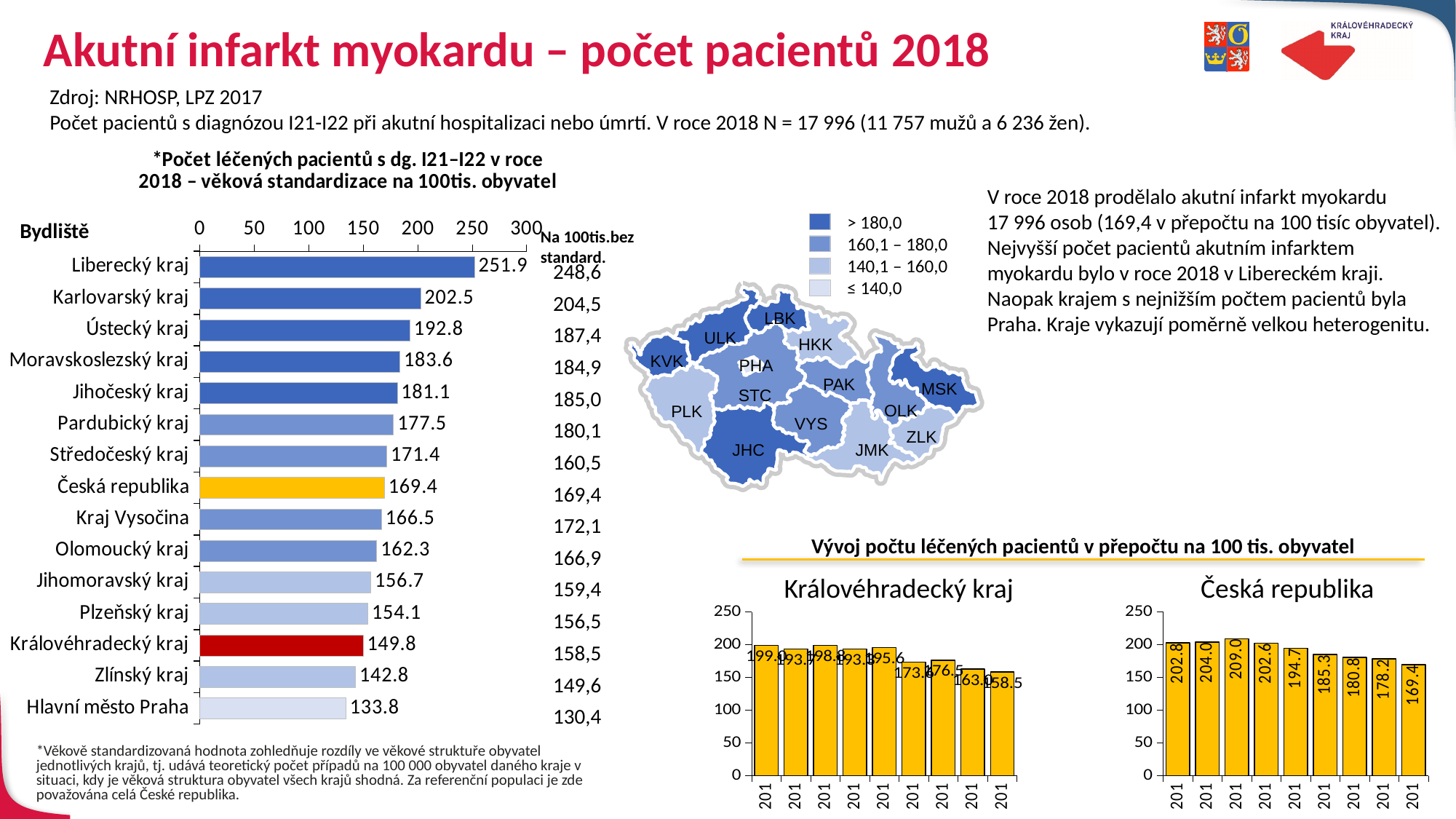
In the Česká republika chart at the bottom right, what is the highest value shown? 209.0 In the bar chart of regions, what is the difference between the values for Liberecký kraj and Hlavní město Praha? 118.1 In the Královéhradecký kraj chart at the bottom, do the values generally rise or fall from left to right? fall What type of chart is used to show the values by region (Bydliště)? bar chart In the bar chart of regions (Počet léčených pacientů s dg. I21–I22 v roce 2018), what is the value for Liberecký kraj? 251.9 In the bar chart of regions, what is the value for Česká republika? 169.4 In the bar chart of regions, which region has the highest value? Liberecký kraj In the Česká republika chart at the bottom right, what is the value of the last (rightmost) bar? 169.4 In the bar chart of regions, which region has the lowest value? Hlavní město Praha In the bar chart of regions, what is the value for Královéhradecký kraj? 149.8 In the bar chart of regions, how many categories (bars) are shown? 15 In the bar chart of regions, which has the larger value, Karlovarský kraj or Ústecký kraj? Karlovarský kraj